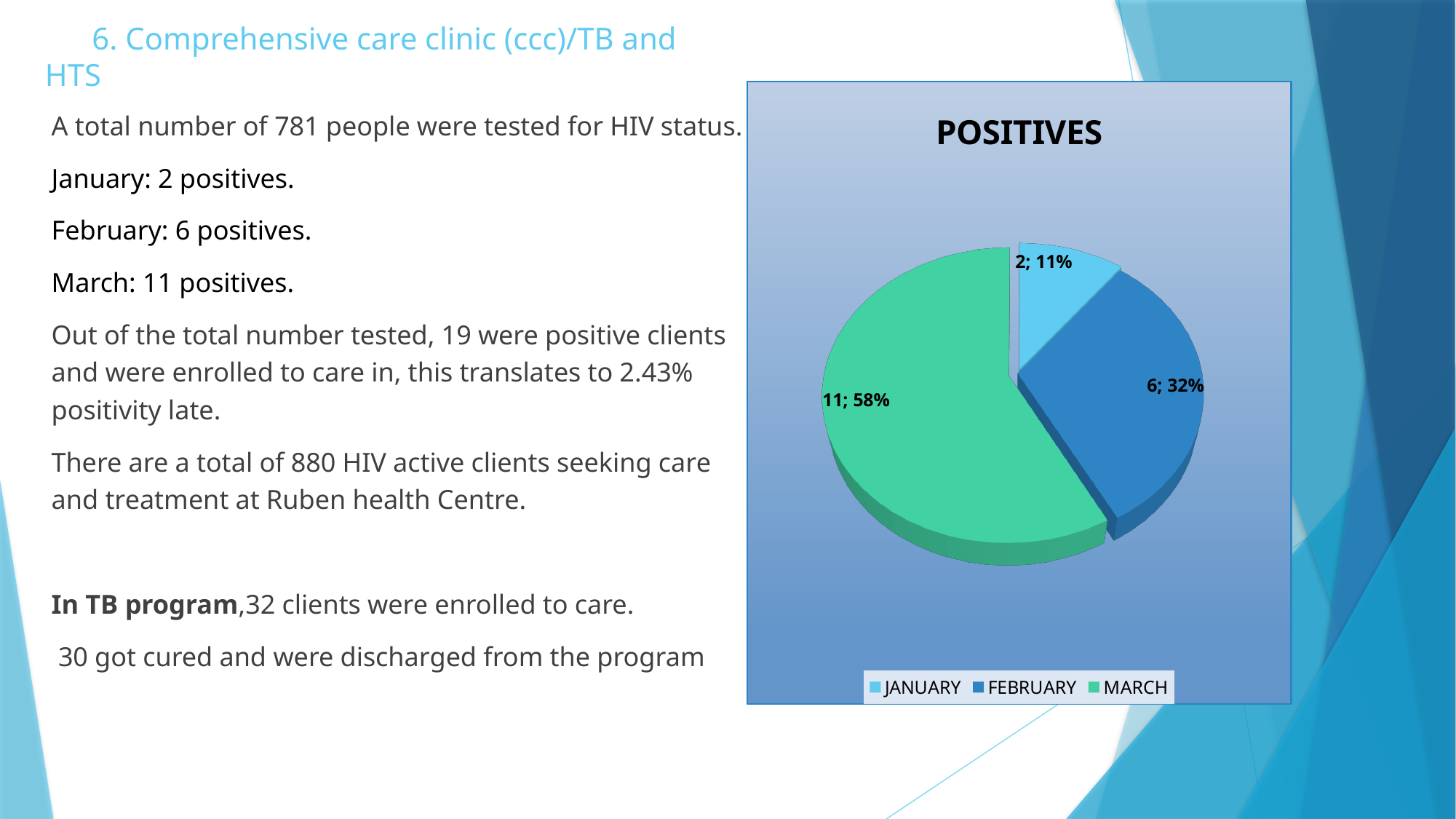
How many entries does the legend list? 3 What kind of chart is shown on the slide? pie chart Which month has the largest slice of the pie? MARCH What is the difference between the MARCH and JANUARY values? 9 What share of the pie does FEBRUARY represent? 32% What is the value for MARCH in the pie chart? 11 How many slices does the pie chart have? 3 What is the title of the chart? POSITIVES What is the value for JANUARY in the pie chart? 2 Which is larger, the value for FEBRUARY or the value for JANUARY? FEBRUARY What is the value for FEBRUARY in the pie chart? 6 Which month has the smallest slice of the pie? JANUARY